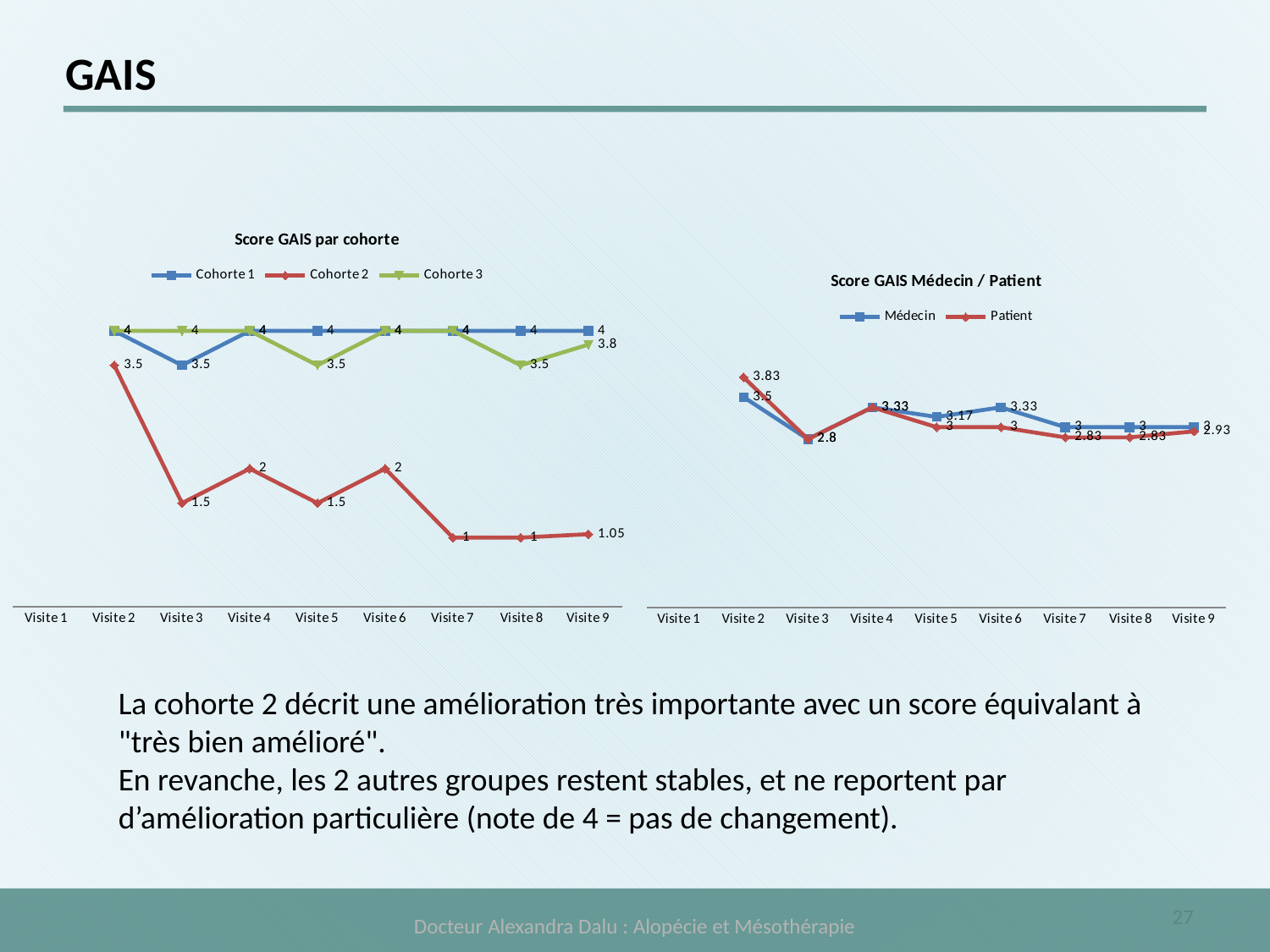
In the 'Score GAIS par cohorte' chart, how many series does the legend list? 3 In the 'Score GAIS par cohorte' chart, at which visit does Cohorte 2 reach its highest value? Visite 2 In the 'Score GAIS Médecin / Patient' chart, what is the value for Médecin at Visite 5? 3.17 In the 'Score GAIS par cohorte' chart, what is the value for Cohorte 3 at Visite 9? 3.8 In the 'Score GAIS Médecin / Patient' chart, what is the value for Patient at Visite 2? 3.83 In the 'Score GAIS Médecin / Patient' chart, at which visit do both series reach their lowest value? Visite 3 In the 'Score GAIS par cohorte' chart, what is the value for Cohorte 1 at Visite 3? 3.5 What kind of chart is 'Score GAIS Médecin / Patient'? line chart In the 'Score GAIS par cohorte' chart, does Cohorte 2 generally rise or fall from Visite 2 to Visite 9? fall In the 'Score GAIS par cohorte' chart, what is the value for Cohorte 2 at Visite 9? 1.05 In the 'Score GAIS par cohorte' chart, what is the difference between Cohorte 1 and Cohorte 2 at Visite 7? 3 In the 'Score GAIS Médecin / Patient' chart, which series has the larger value at Visite 6, Médecin or Patient? Médecin